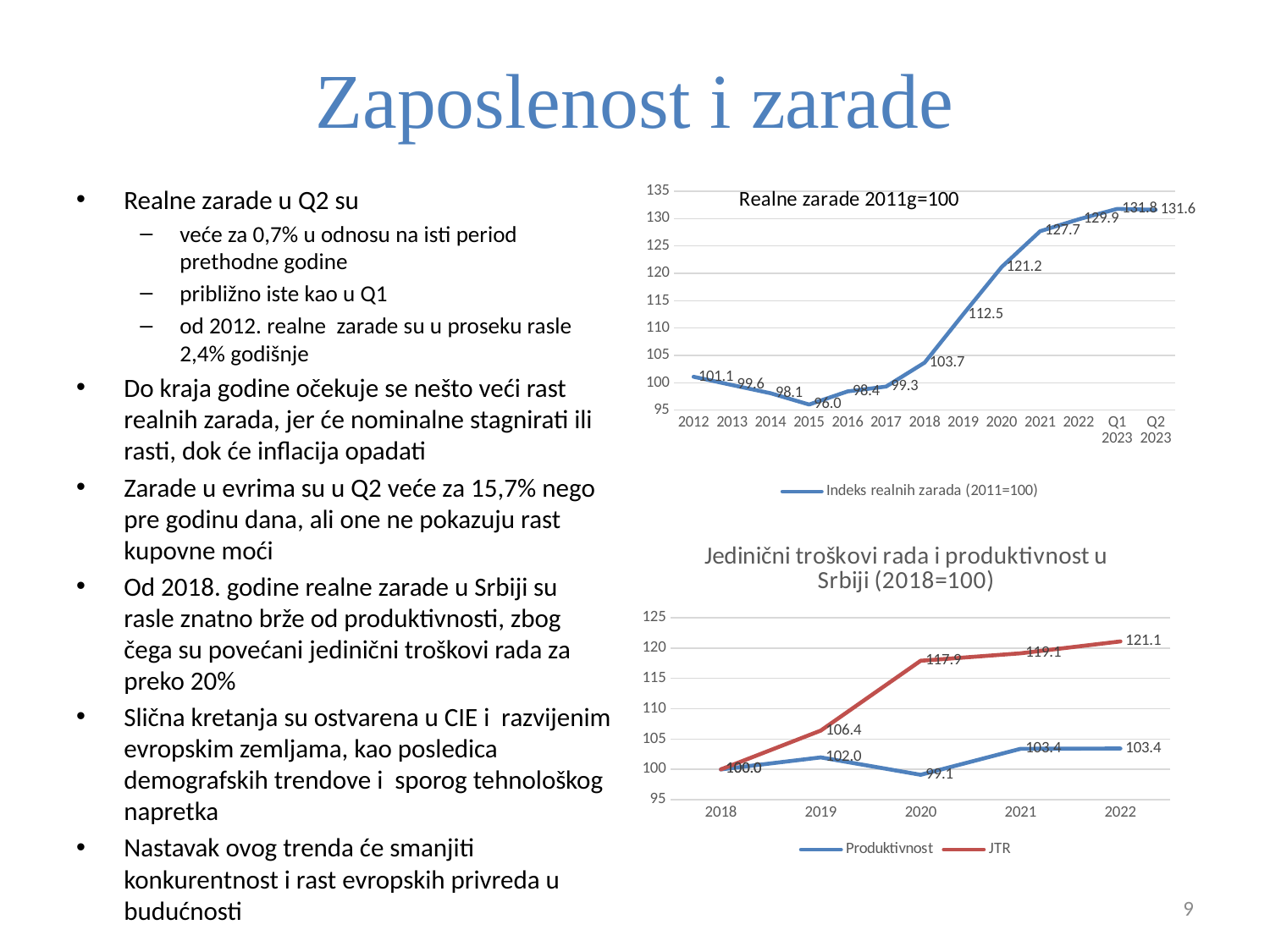
In the chart 'Realne zarade 2011g=100', which year has the lowest value? 2015 In the chart 'Jedinični troškovi rada i produktivnost u Srbiji (2018=100)', what is the JTR value for 2020? 117.9 In the chart 'Realne zarade 2011g=100', what is the difference between the values for 2022 and 2018? 26.2 What type of chart is the bottom chart on the slide? line chart In the chart 'Jedinični troškovi rada i produktivnost u Srbiji (2018=100)', which series is higher in 2019, Produktivnost or JTR? JTR In the chart 'Realne zarade 2011g=100', do the values generally rise or fall from 2015 to 2022? rise In the chart 'Jedinični troškovi rada i produktivnost u Srbiji (2018=100)', what is the difference between JTR and Produktivnost in 2022? 17.7 In the chart 'Realne zarade 2011g=100', what is the value for 2019? 112.5 In the chart 'Realne zarade 2011g=100', what is the value for Q2 2023? 131.6 In the chart 'Jedinični troškovi rada i produktivnost u Srbiji (2018=100)', how many series does the legend list? 2 In the chart 'Realne zarade 2011g=100', how many data points are plotted? 13 In the chart 'Jedinični troškovi rada i produktivnost u Srbiji (2018=100)', what is the Produktivnost value for 2021? 103.4